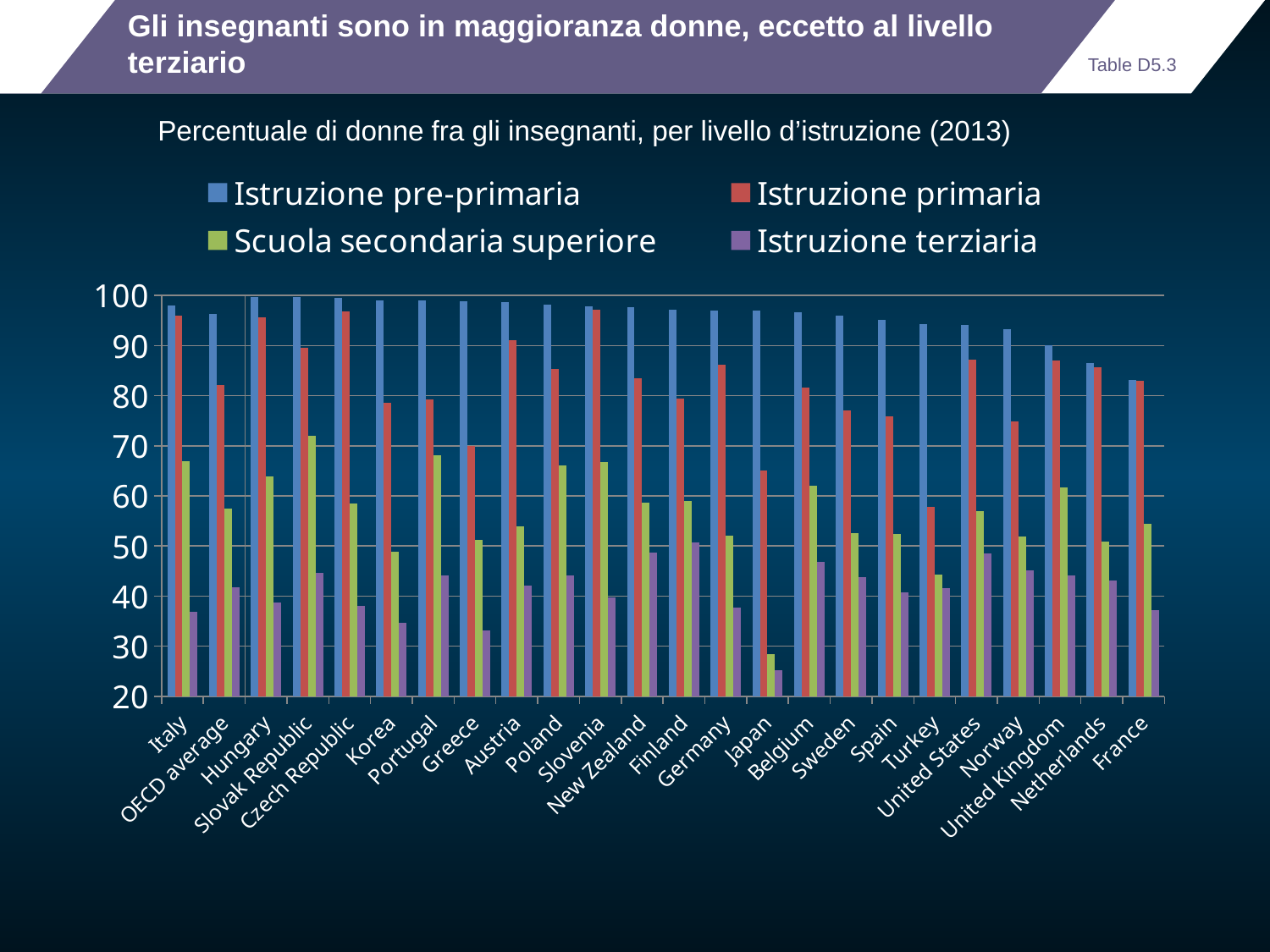
What kind of chart is shown on the slide? bar chart Which category has the lowest value for Scuola secondaria superiore? Japan Which category has the lowest value for Istruzione terziaria? Japan Which series is shown in green in the legend? Scuola secondaria superiore Is the value for Istruzione primaria in Turkey greater or less than 60? less How many series does the legend list? 4 Do the values for Istruzione pre-primaria rise or fall from left to right along the x axis? fall Is the value for Scuola secondaria superiore in Japan greater or less than 30? less Which is larger: the Istruzione primaria value for Italy or for Japan? Italy Is the value for Istruzione terziaria in Italy greater or less than 40? less How many countries/categories are shown on the x axis? 24